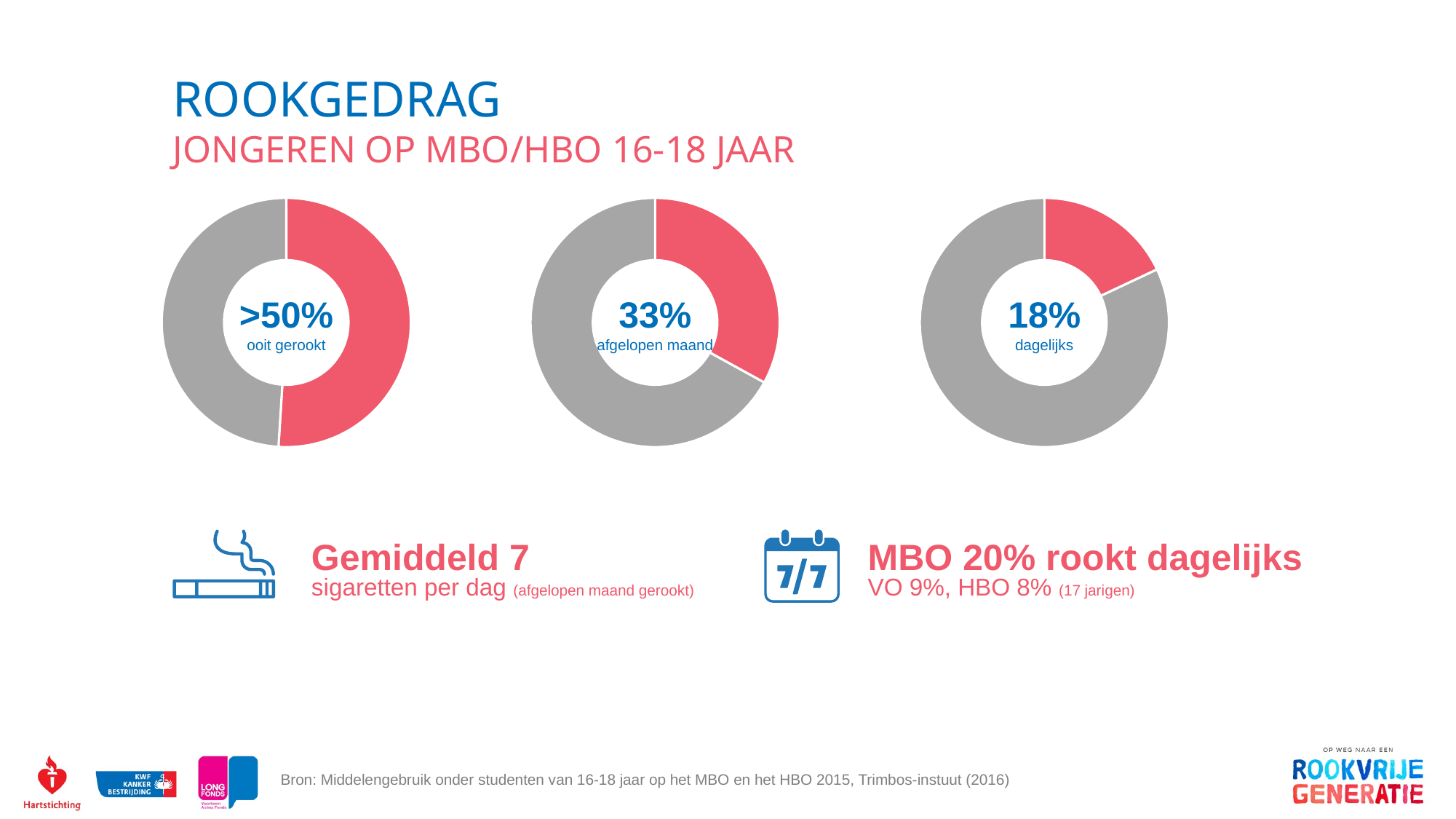
What share of the right-hand donut chart is coloured red? 18% What kind of chart is used to show the three percentages on the slide? Donut (pie) chart Which of the three donut charts shows the largest red share? ooit gerookt (>50%) Which of the three donut charts shows the smallest red share? dagelijks (18%) Is the red share in the middle donut chart (afgelopen maand) larger or smaller than in the right-hand donut chart (dagelijks)? larger How many slices does each donut chart have? 2 What value is shown in the centre of the right-hand donut chart (dagelijks)? 18% How many donut charts are shown on the slide? 3 What value is shown in the centre of the left-hand donut chart (ooit gerookt)? >50% What is the difference in percentage points between the middle donut chart (33%) and the right-hand donut chart (18%)? 15 percentage points What value is shown in the centre of the middle donut chart (afgelopen maand)? 33% What label appears under the percentage in the left-hand donut chart? ooit gerookt